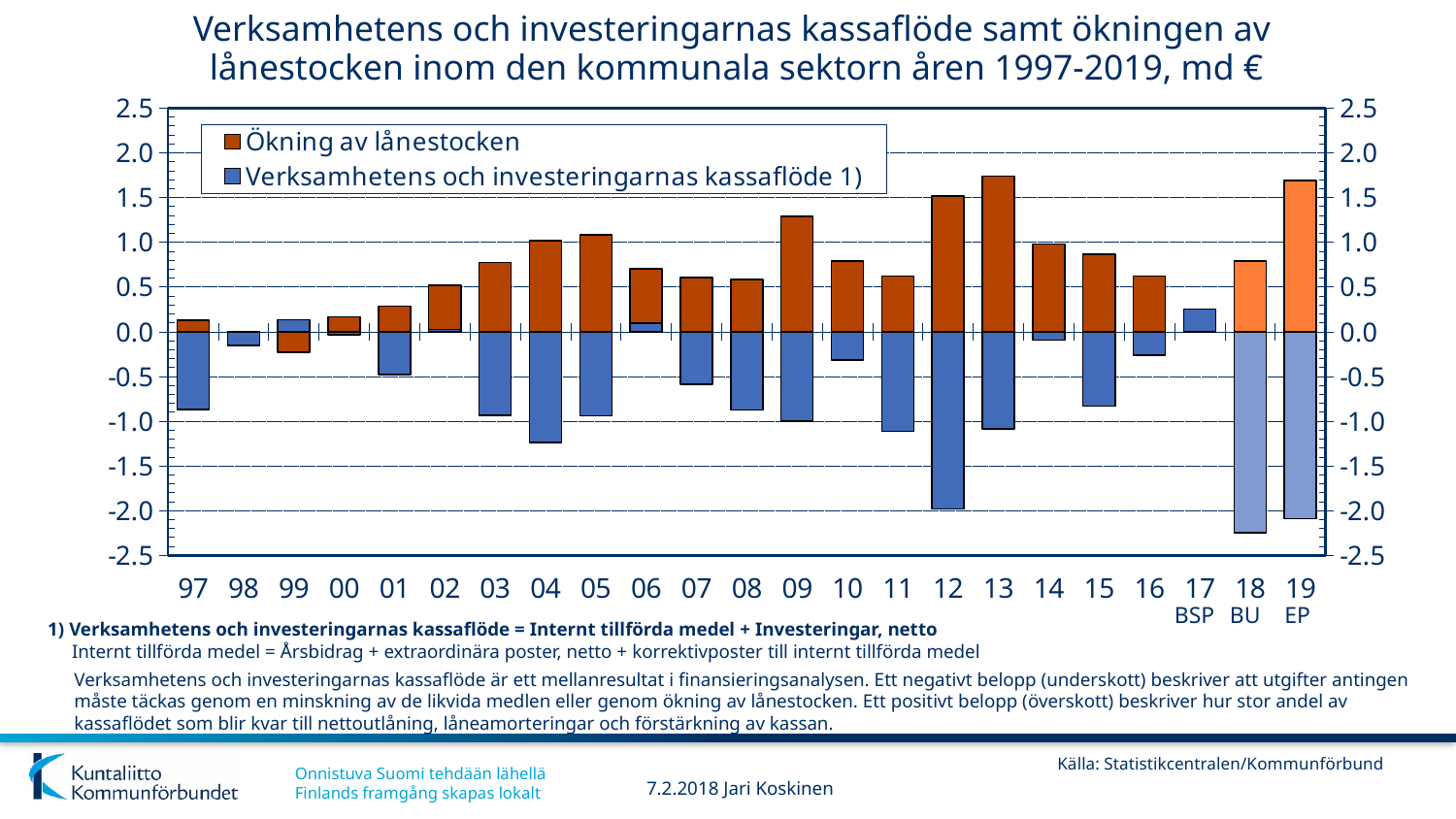
What kind of chart is shown on the slide? bar chart Which year has the highest value of Verksamhetens och investeringarnas kassaflöde? 17 How many years are shown on the x axis? 23 Is the value of Verksamhetens och investeringarnas kassaflöde for 2017 greater or less than 0.0? greater What is the source given for the chart data? Statistikcentralen/Kommunförbund Which is larger, Verksamhetens och investeringarnas kassaflöde for 2012 or for 2013? 2013 Is the value of Ökning av lånestocken for 2012 greater or less than 1.0? greater Which is larger, Ökning av lånestocken for 2013 or for 2014? 2013 Is the value of Ökning av lånestocken for 2003 greater or less than 0.5? greater How many series does the legend list? 2